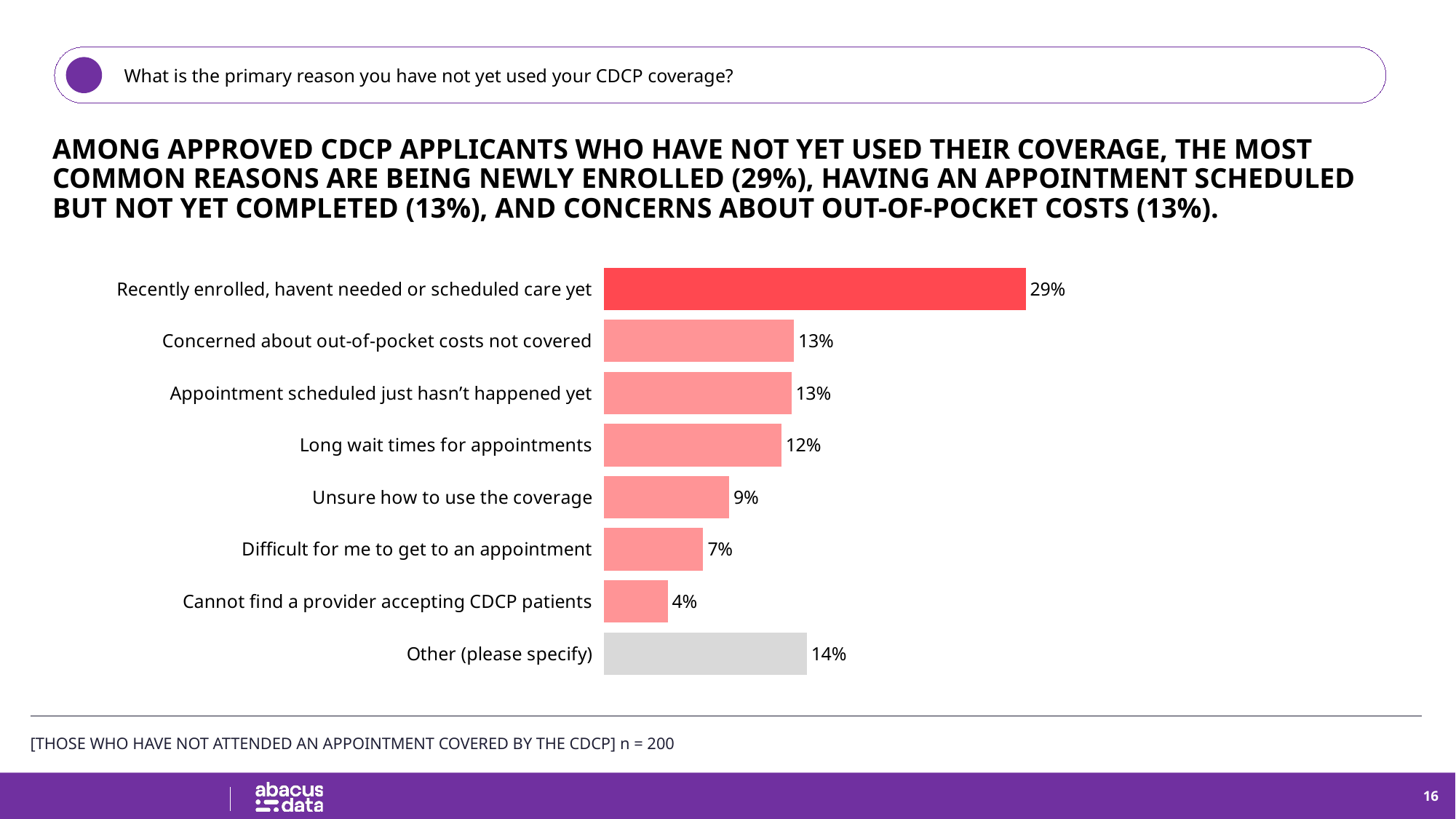
What is the difference between 'Other (please specify)' and 'Long wait times for appointments'? 2 percentage points What type of chart is shown on the slide? Bar chart What is the value for 'Other (please specify)'? 14% Which is larger: 'Difficult for me to get to an appointment' or 'Cannot find a provider accepting CDCP patients'? Difficult for me to get to an appointment What is the difference between 'Recently enrolled, havent needed or scheduled care yet' and 'Concerned about out-of-pocket costs not covered'? 16 percentage points What percentage cited 'Unsure how to use the coverage'? 9% Which reason has the highest percentage? Recently enrolled, havent needed or scheduled care yet What is the value for 'Long wait times for appointments'? 12% How many reason categories are shown in the chart? 8 What percentage of respondents said they recently enrolled and haven't needed or scheduled care yet? 29% Which reason has the lowest percentage? Cannot find a provider accepting CDCP patients Which bar is shown in grey rather than red or pink? Other (please specify)